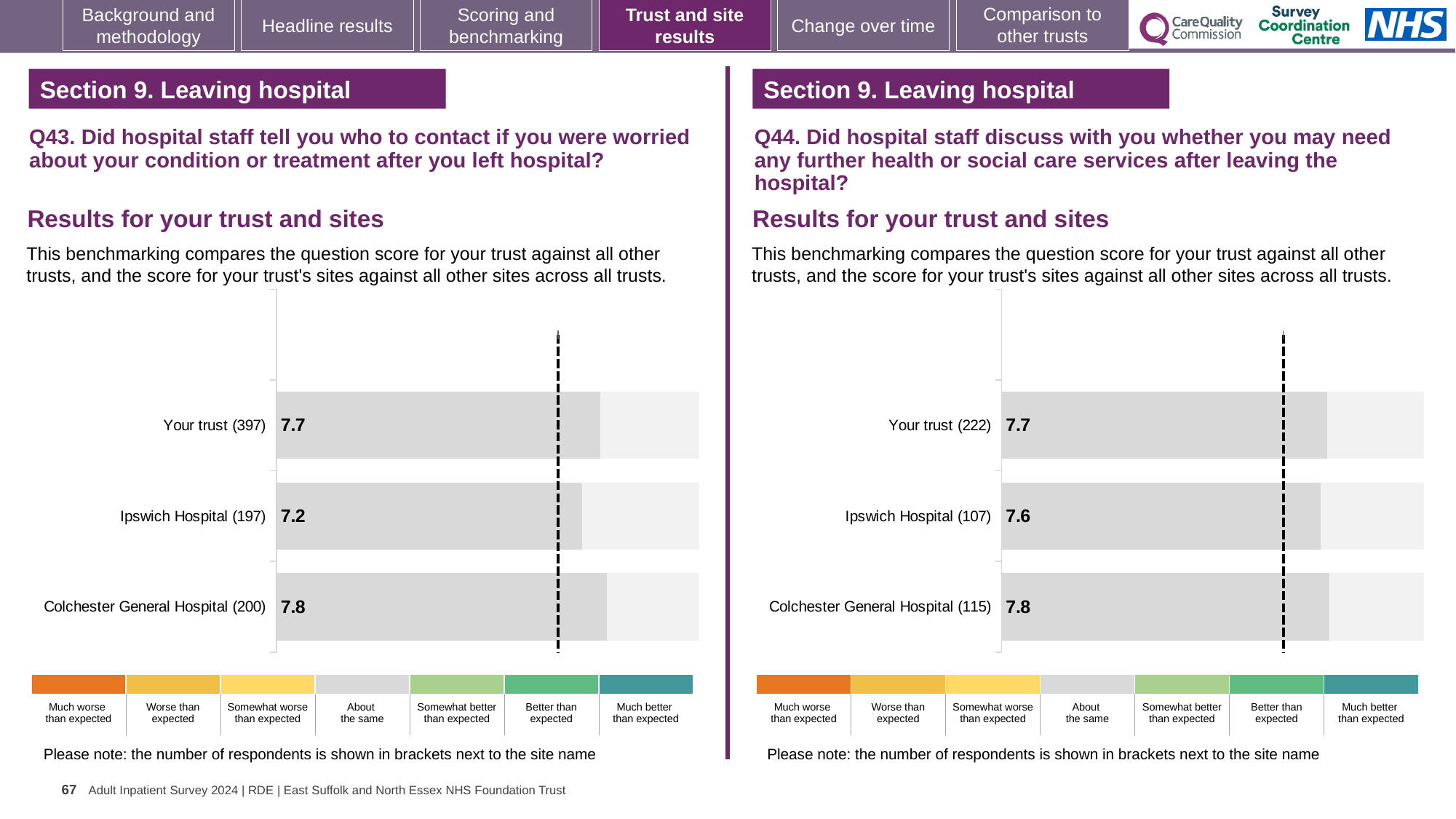
In the Q44 chart on the right, which site or trust has the lowest score? Ipswich Hospital In the Q43 chart on the left, what is the score for Ipswich Hospital? 7.2 In the Q43 chart on the left, how many respondents are shown in brackets for Your trust? 397 In the Q43 chart on the left, which site or trust has the highest score? Colchester General Hospital In the Q43 chart on the left, what is the difference between the scores for Colchester General Hospital and Ipswich Hospital? 0.6 In the Q44 chart on the right, what is the score for Ipswich Hospital? 7.6 What type of chart is used in the Q43 chart on the left? Bar chart In the Q44 chart on the right, what is the difference between the scores for Colchester General Hospital and Your trust? 0.1 In the Q43 chart on the left, what is the score for Your trust? 7.7 How many bars are plotted in the Q44 chart on the right? 3 In the Q44 chart on the right, what is the score for Colchester General Hospital? 7.8 In the Q43 chart on the left, which site or trust has the lowest score? Ipswich Hospital